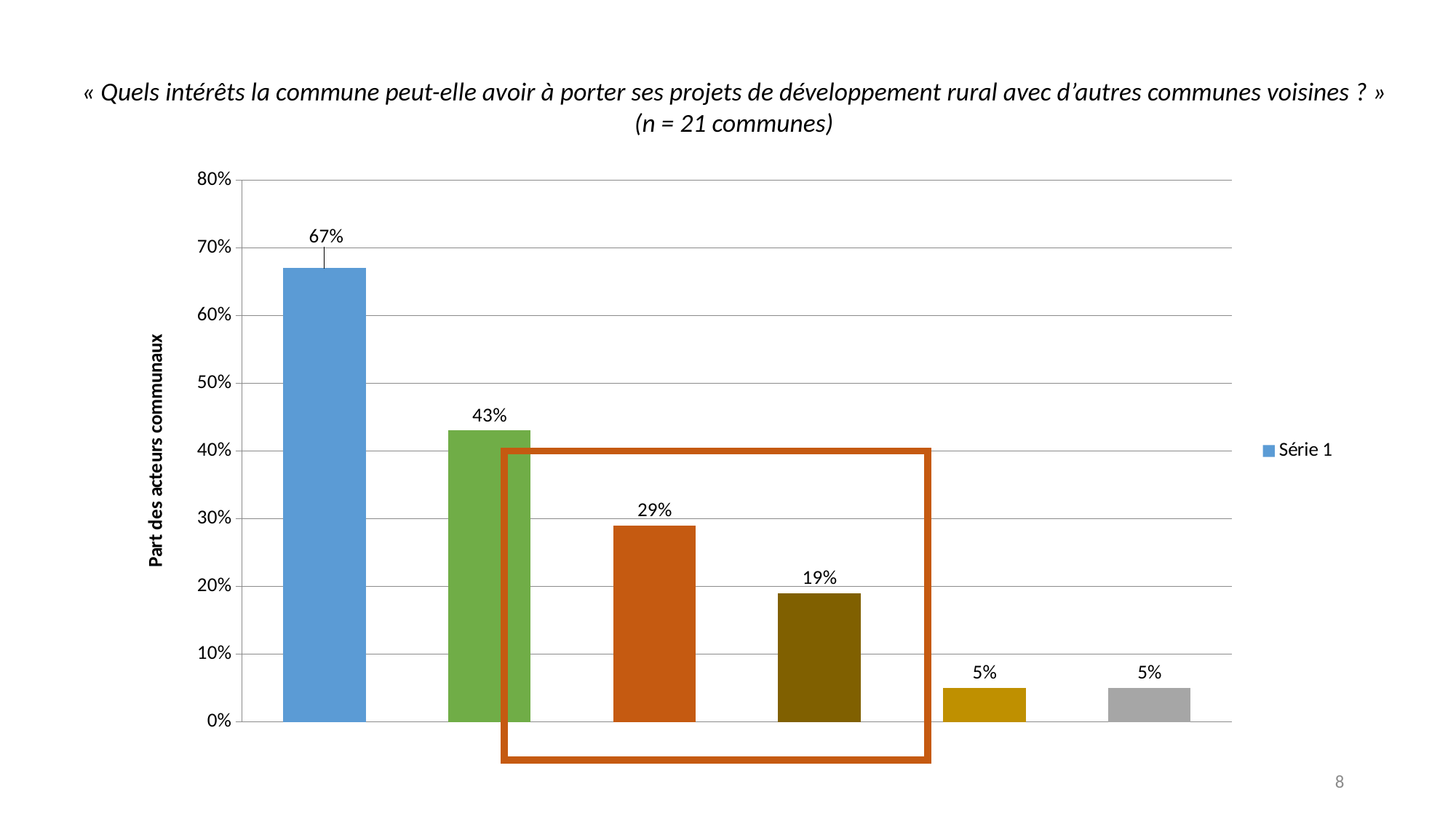
How many bars are plotted in the chart? 6 What is the label of the vertical axis? Part des acteurs communaux What is the value of the tallest bar in the chart? 67% What type of chart is shown on the slide? bar chart Which is larger, the third bar from the left or the fourth bar from the left? the third bar (29%) How many series does the legend list? 1 What is the value of the third (orange) bar from the left? 29% What is the value of the second (green) bar from the left? 43% What is the value of the fourth (dark brown) bar from the left? 19% What is the difference between the first bar (67%) and the second bar (43%)? 24% What is the value of the first (blue) bar from the left? 67% What is the value of the two shortest bars in the chart? 5%